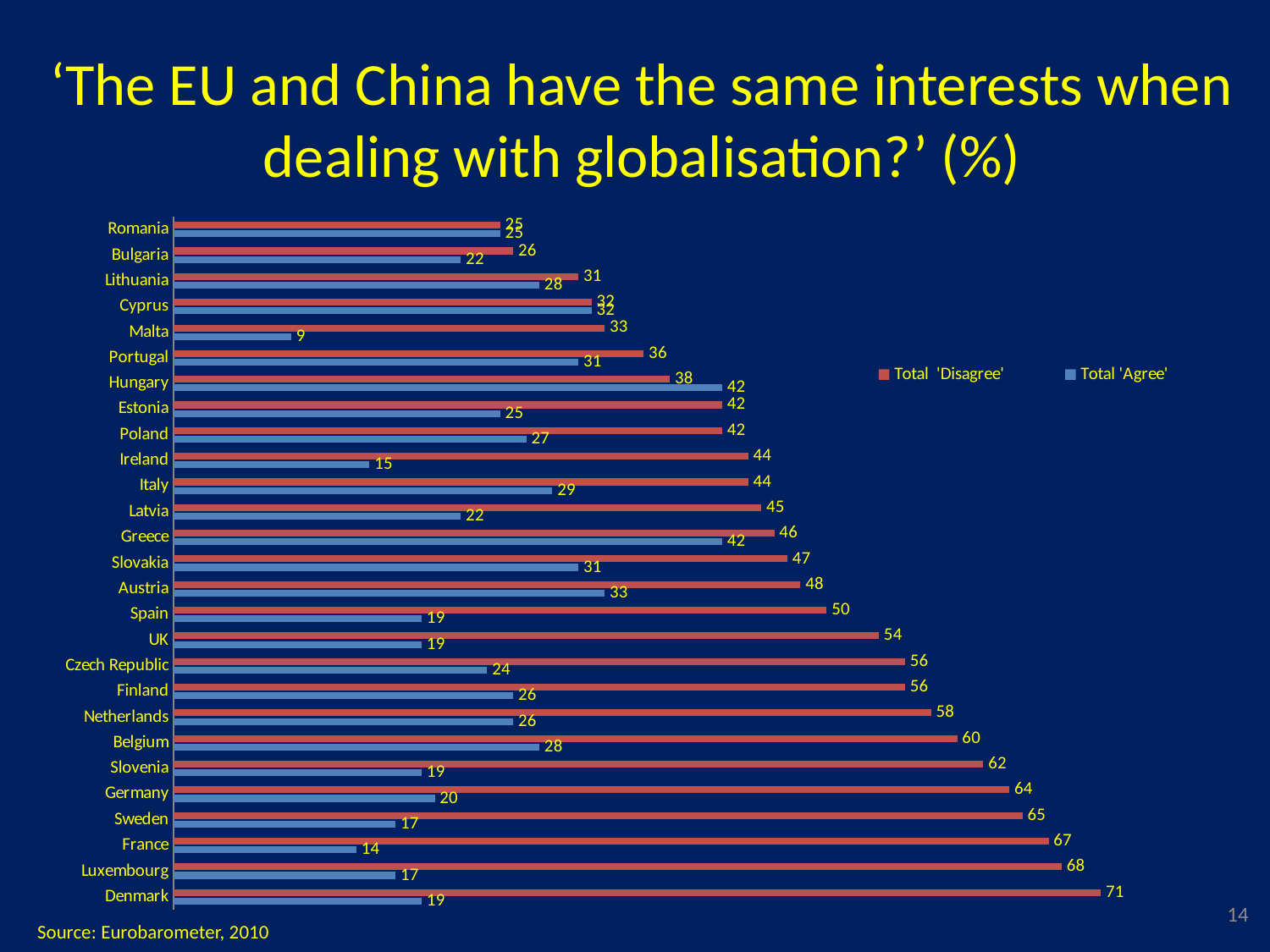
What kind of chart is shown on the slide? Bar chart What is the Total 'Agree' value for Malta? 9 What is the source cited for the chart? Eurobarometer, 2010 How many series does the legend list? 2 Which country has the lowest Total 'Agree' value? Malta Which country has the lowest Total 'Disagree' value? Romania What is the Total 'Disagree' value for Hungary? 38 Which country has the highest Total 'Disagree' value? Denmark What is the difference between the Total 'Disagree' and Total 'Agree' values for Denmark? 52 How many countries are shown in the chart? 27 Which is larger: the Total 'Disagree' value for Germany or for Belgium? Germany What is the Total 'Disagree' value for Denmark? 71